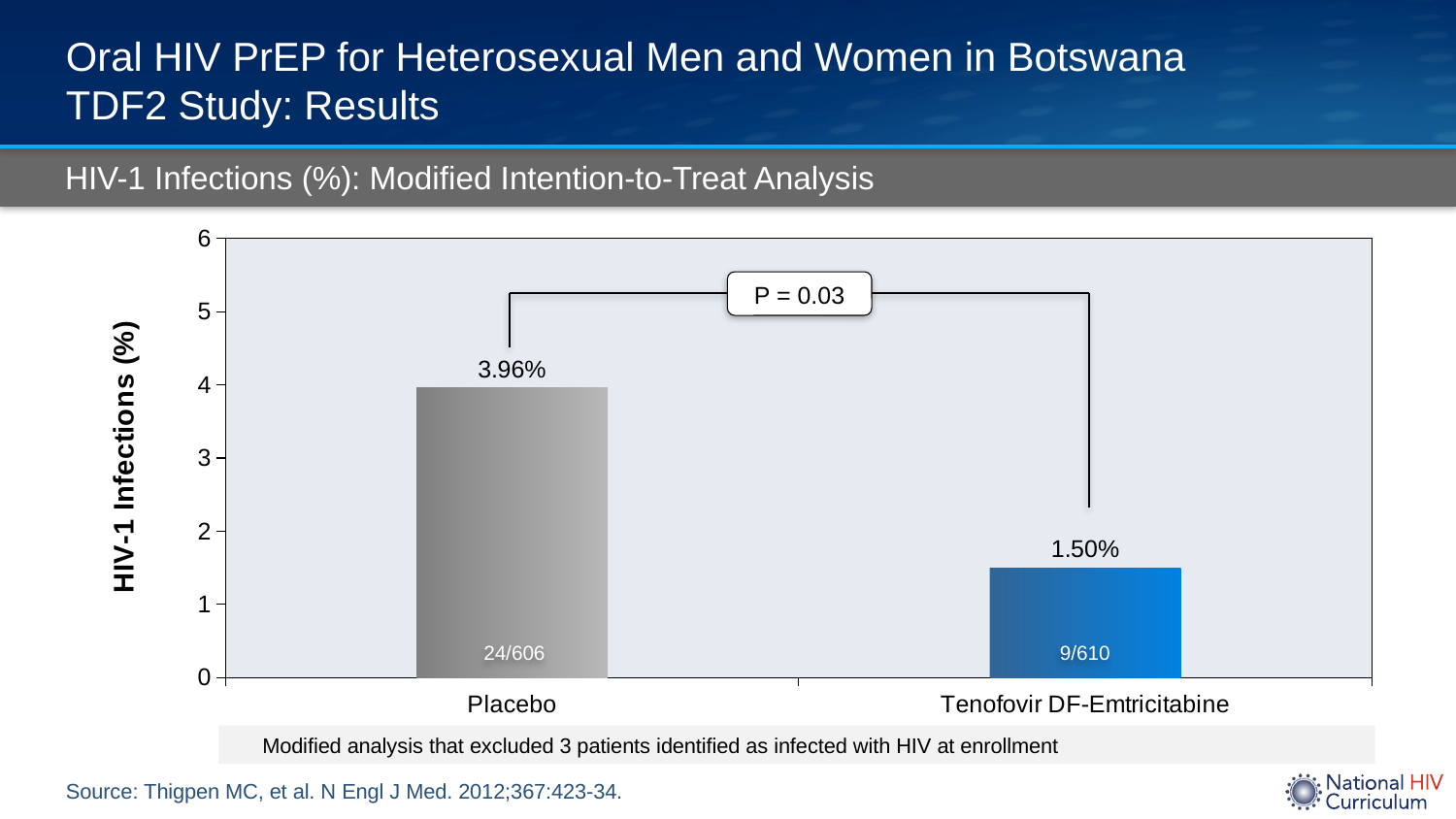
Which group has the higher HIV-1 infection rate? Placebo How many infections out of how many participants are shown for the Tenofovir DF-Emtricitabine group? 9/610 Is the HIV-1 infection rate for Placebo greater or less than 3? greater Is the HIV-1 infection rate for Tenofovir DF-Emtricitabine greater or less than 2? less What is the HIV-1 infection rate for the Placebo group? 3.96% What is the difference in HIV-1 infection rate between the Placebo and Tenofovir DF-Emtricitabine groups? 2.46% Which group has the lower HIV-1 infection rate? Tenofovir DF-Emtricitabine What kind of chart is shown on the slide? Bar chart What P value is shown on the chart? P = 0.03 How many infections out of how many participants are shown for the Placebo group? 24/606 How many groups are shown on the chart? 2 What is the HIV-1 infection rate for the Tenofovir DF-Emtricitabine group? 1.50%